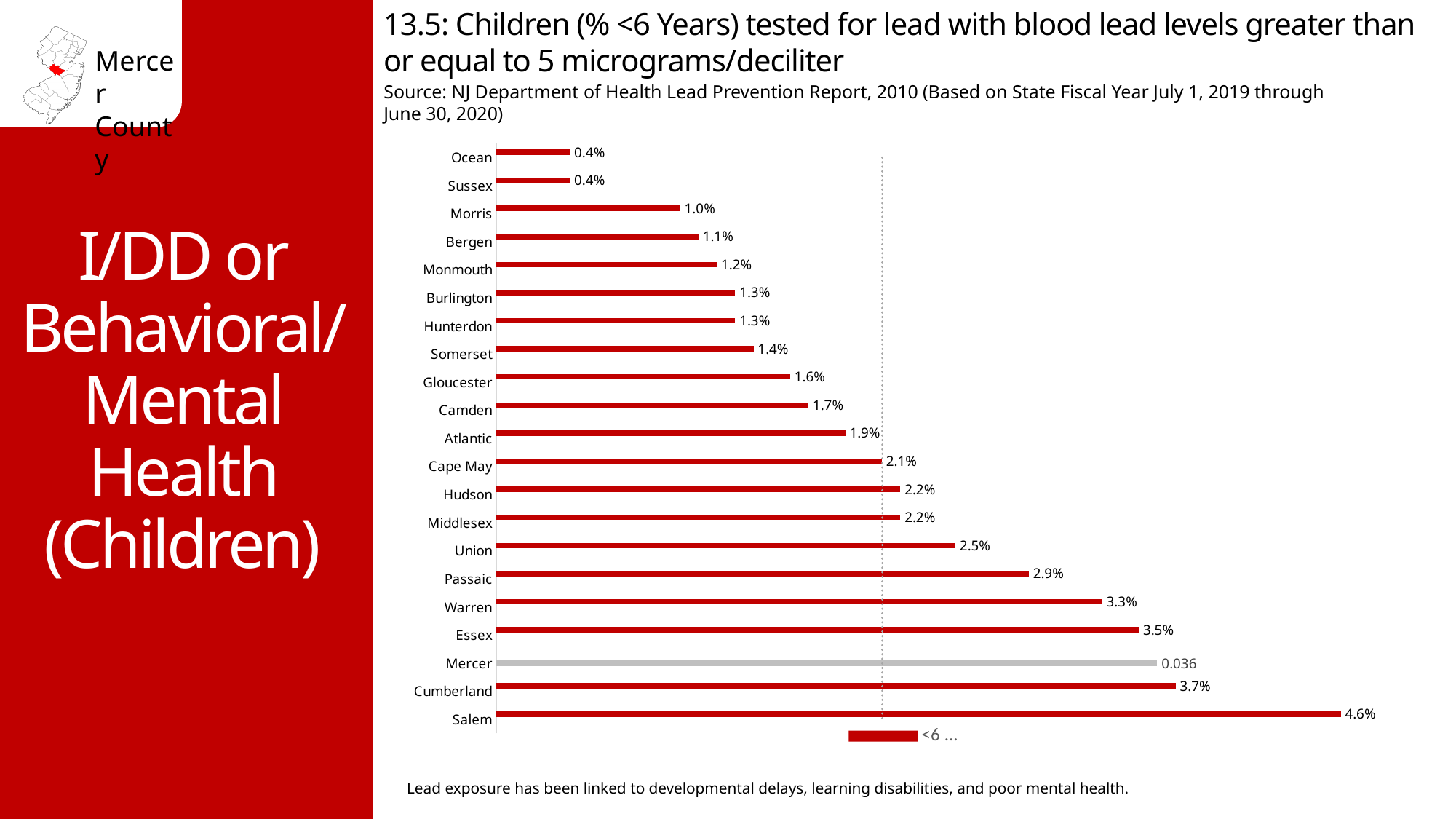
What is the value shown for Salem? 4.6% Which county has the highest value in the chart? Salem What is the value shown for Camden? 1.7% What is the value shown for Passaic? 2.9% What is the value labeled on the Mercer bar? 0.036 What colour is the Mercer bar, unlike the other bars? Gray Which two counties share the lowest value in the chart? Ocean and Sussex How many counties are shown in the chart? 21 What is the difference between the values for Salem and Cumberland? 0.9% Which has a larger value, Essex or Warren? Essex What is the difference between the values for Union and Atlantic? 0.6% What type of chart is shown on the slide? Bar chart